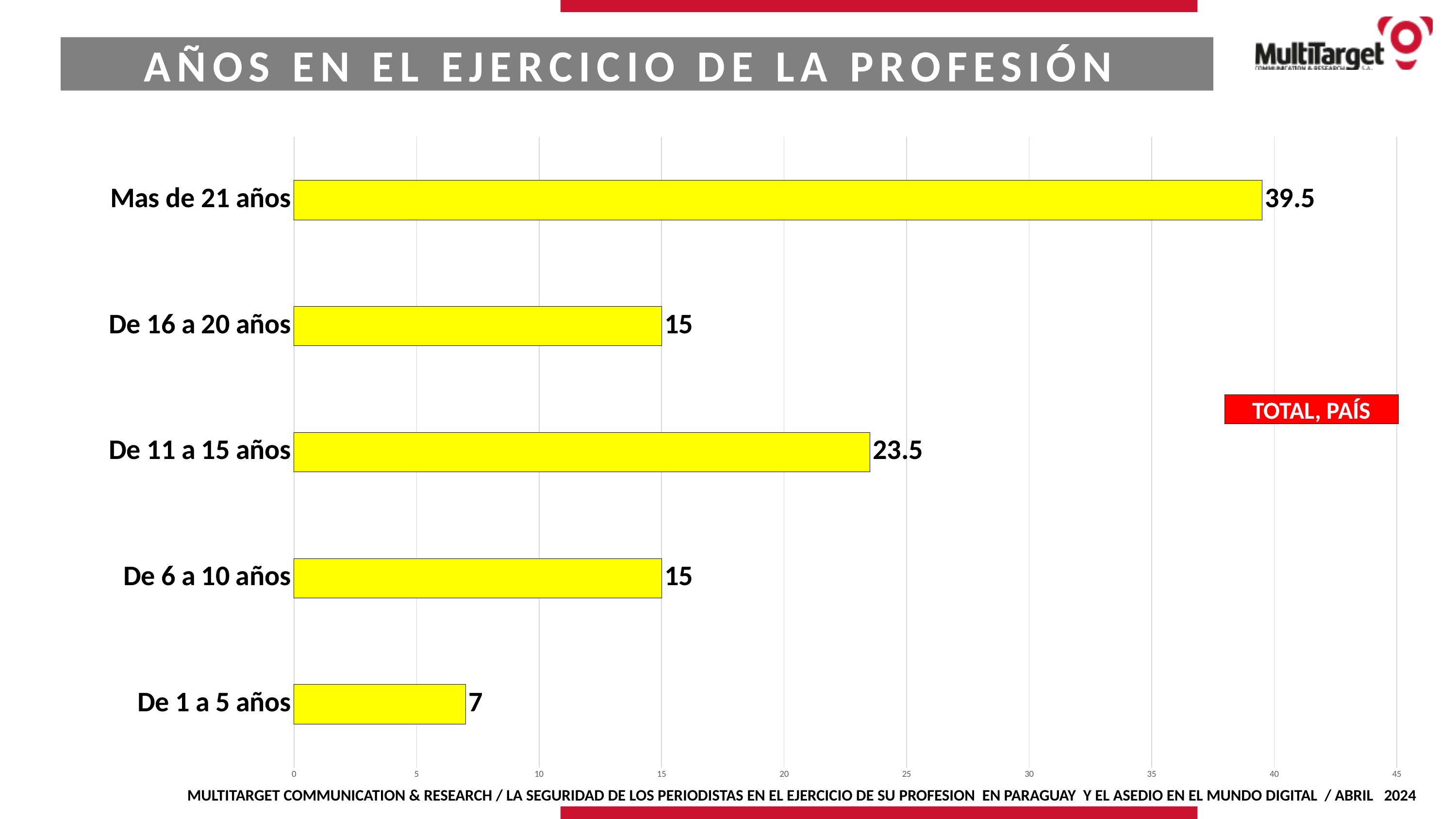
What kind of chart is shown on the slide? Bar chart What is the value for "De 16 a 20 años"? 15 Which category has the highest value? Mas de 21 años What is the value for "De 11 a 15 años"? 23.5 What is the difference between the values for "De 6 a 10 años" and "De 1 a 5 años"? 8 How many categories are shown in the chart? 5 What is the title of the slide? AÑOS EN EL EJERCICIO DE LA PROFESIÓN What is the difference between the values for "Mas de 21 años" and "De 11 a 15 años"? 16 Which category has the lowest value? De 1 a 5 años What is the value for "De 1 a 5 años"? 7 What is the value for "Mas de 21 años"? 39.5 Which is larger, the value for "De 11 a 15 años" or the value for "De 16 a 20 años"? De 11 a 15 años